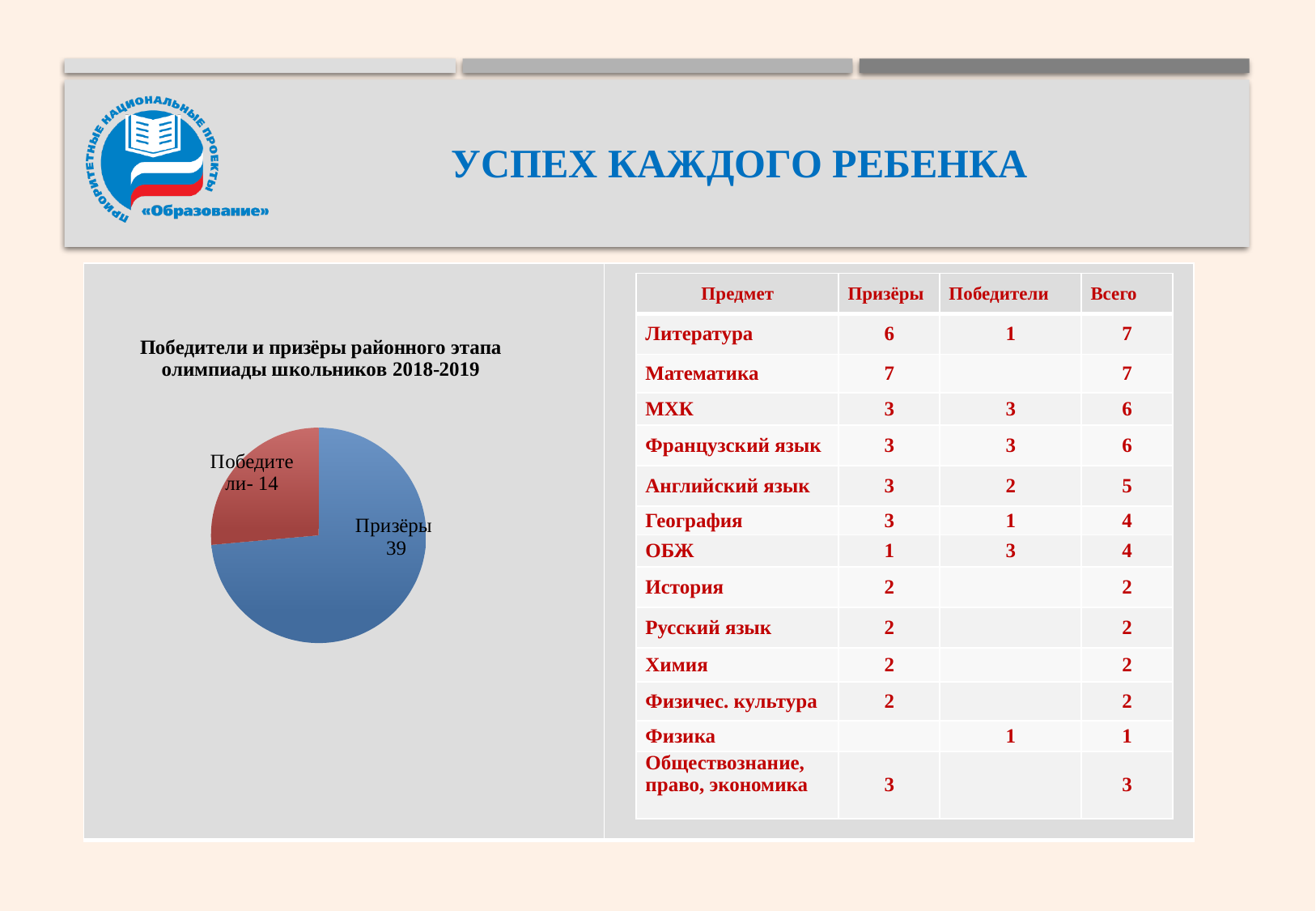
What colour is the Призёры slice in the pie chart? blue Which slice of the pie chart is the smallest? Победители What is the value for Победители in the pie chart? 14 What is the value for Призёры in the pie chart? 39 What is the difference between the Призёры and Победители values in the pie chart? 25 Which slice of the pie chart is the largest? Призёры What is the title of the pie chart? Победители и призёры районного этапа олимпиады школьников 2018-2019 What kind of chart is shown on the slide? pie chart Which is larger in the pie chart, Призёры or Победители? Призёры How many slices does the pie chart have? 2 What is the total of the two slices in the pie chart? 53